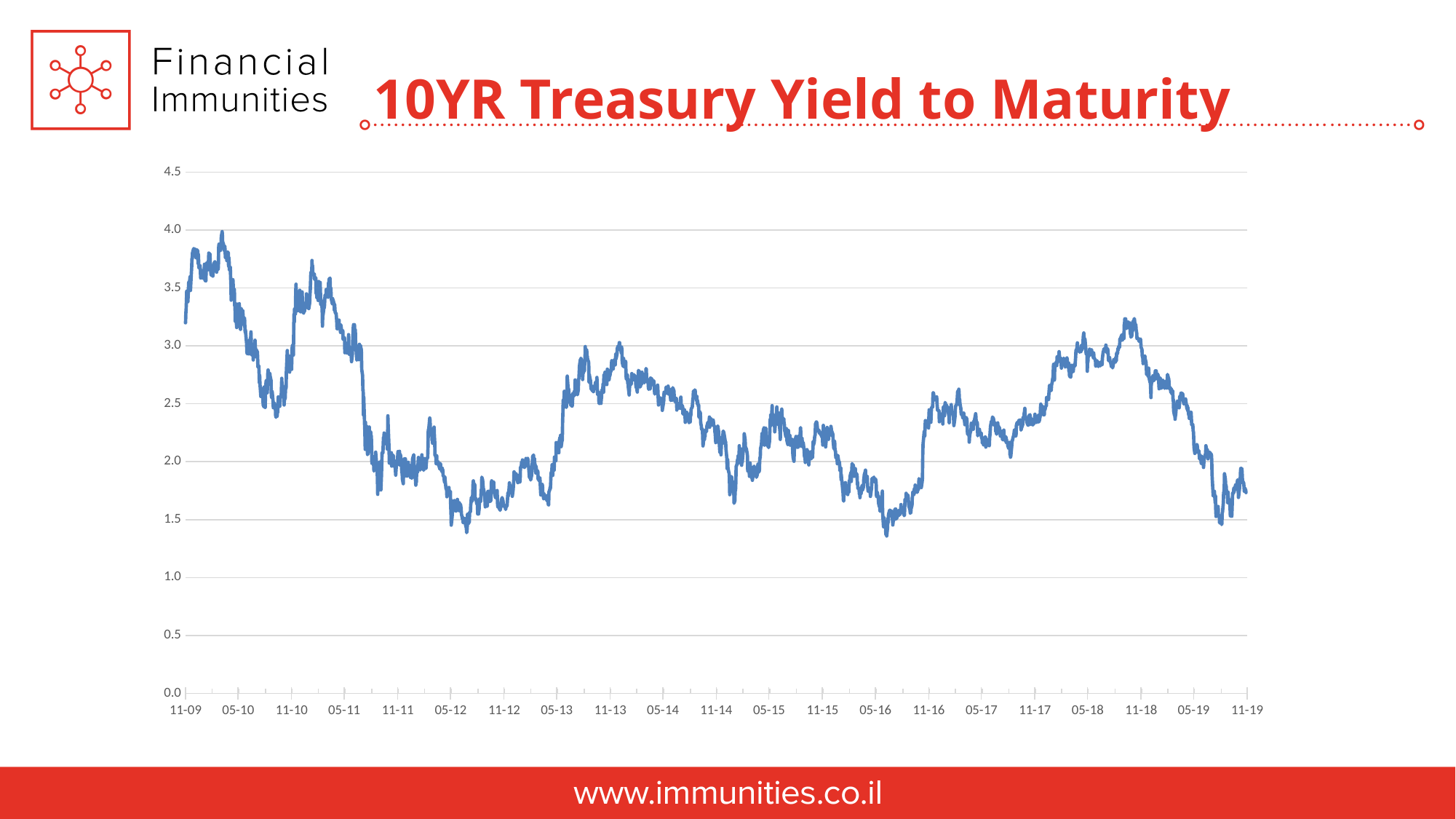
What is the highest value shown on the y axis? 4.5 Overall, does the yield rise or fall from 11-09 to 11-19? fall Which is larger, the value at 11-09 or the value at 11-19? 11-09 What is the title of the chart? 10YR Treasury Yield to Maturity How many date labels are shown along the x axis? 21 What kind of chart is shown on the slide? line chart Is the value at 11-09 greater or less than 3.0? greater Is the value at 11-19 greater or less than 2.0? less Is the value at 05-12 greater or less than 2.0? less Does the yield rise or fall between 11-18 and 11-19? fall